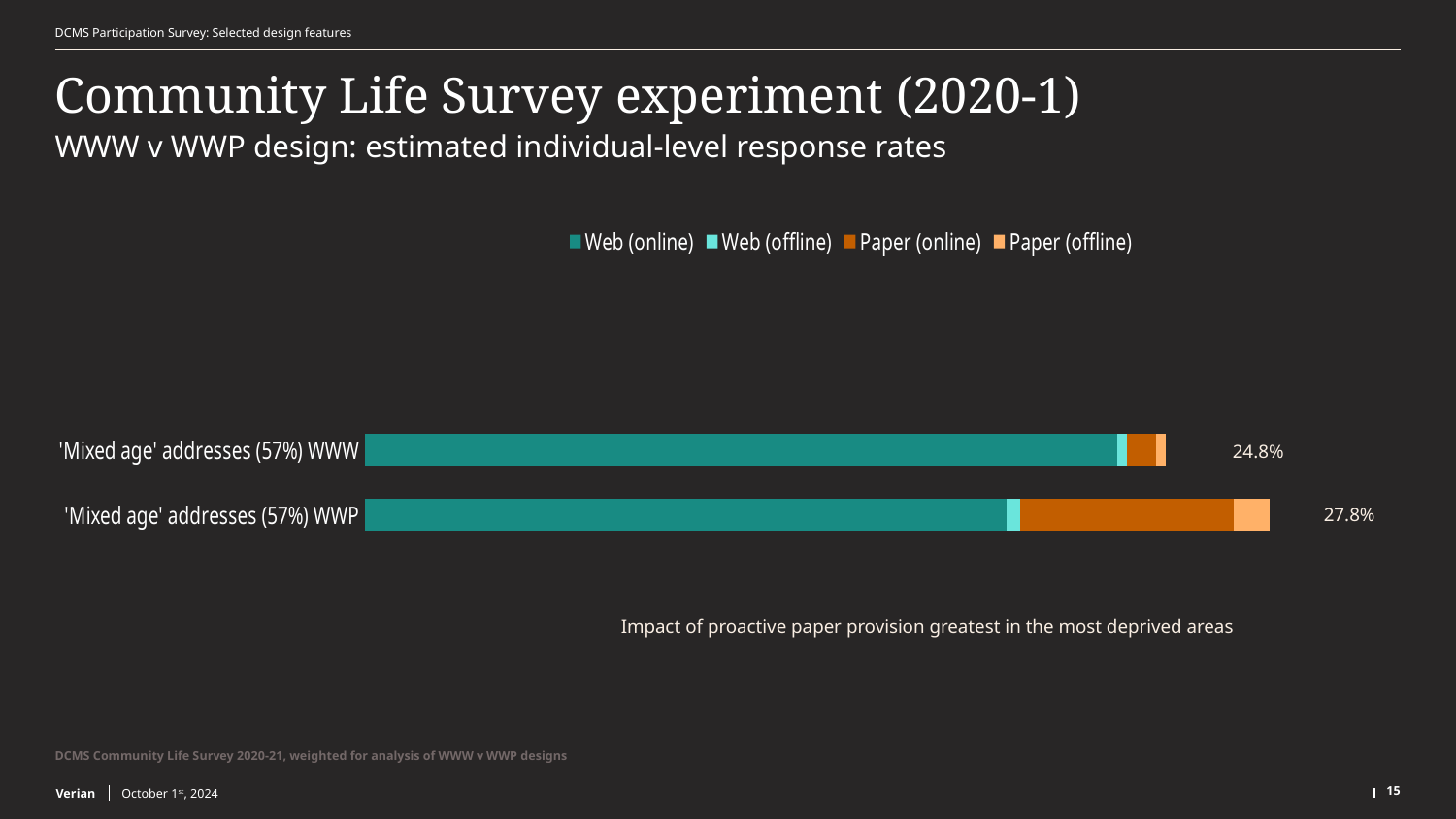
Which bar has the lowest total response rate? 'Mixed age' addresses (57%) WWW What is the difference between the WWP and WWW total response rates? 3.0% What kind of chart is shown on the slide? Stacked bar chart What are the four series named in the legend? Web (online), Web (offline), Paper (online), Paper (offline) How many series does the legend list? 4 What is the total response rate shown for 'Mixed age' addresses (57%) WWW? 24.8% What is the subtitle of the slide describing the chart? WWW v WWP design: estimated individual-level response rates What is the total response rate shown for 'Mixed age' addresses (57%) WWP? 27.8% Which bar has the higher total response rate, WWW or WWP? WWP How many bars are plotted in the chart? 2 Which bar has the larger Web (online) segment, WWW or WWP? WWW Which bar has the larger Paper (online) segment, WWW or WWP? WWP